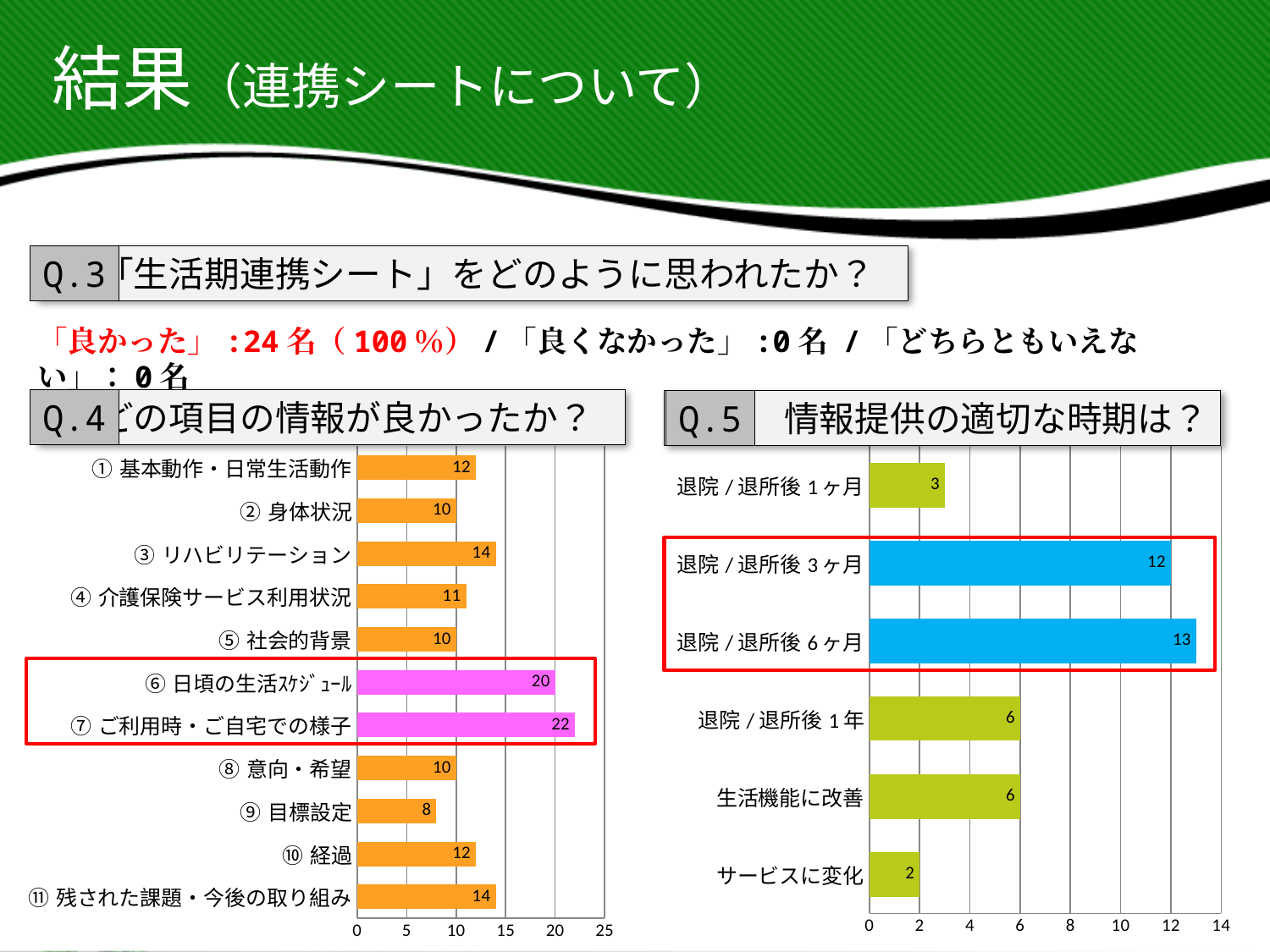
What kind of chart is the Q.5 chart (right)? Bar chart In the Q.4 chart (left), what is the difference between ⑥ 日頃の生活スケジュール and ③ リハビリテーション? 6 In the Q.4 chart (left), what is the value for ⑨ 目標設定? 8 In the Q.4 chart (left), what is the value for ⑦ ご利用時・ご自宅での様子? 22 In the Q.5 chart (right), how many categories are plotted? 6 In the Q.4 chart (left), which category has the lowest value? ⑨ 目標設定 In the Q.5 chart (right), which category has the lowest value? サービスに変化 In the Q.5 chart (right), what is the value for 退院/退所後6ヶ月? 13 In the Q.4 chart (left), how many categories are plotted? 11 In the Q.4 chart (left), which category has the highest value? ⑦ ご利用時・ご自宅での様子 In the Q.5 chart (right), what is the difference between 退院/退所後6ヶ月 and 退院/退所後1ヶ月? 10 In the Q.5 chart (right), which is larger: 退院/退所後3ヶ月 or 退院/退所後1年? 退院/退所後3ヶ月